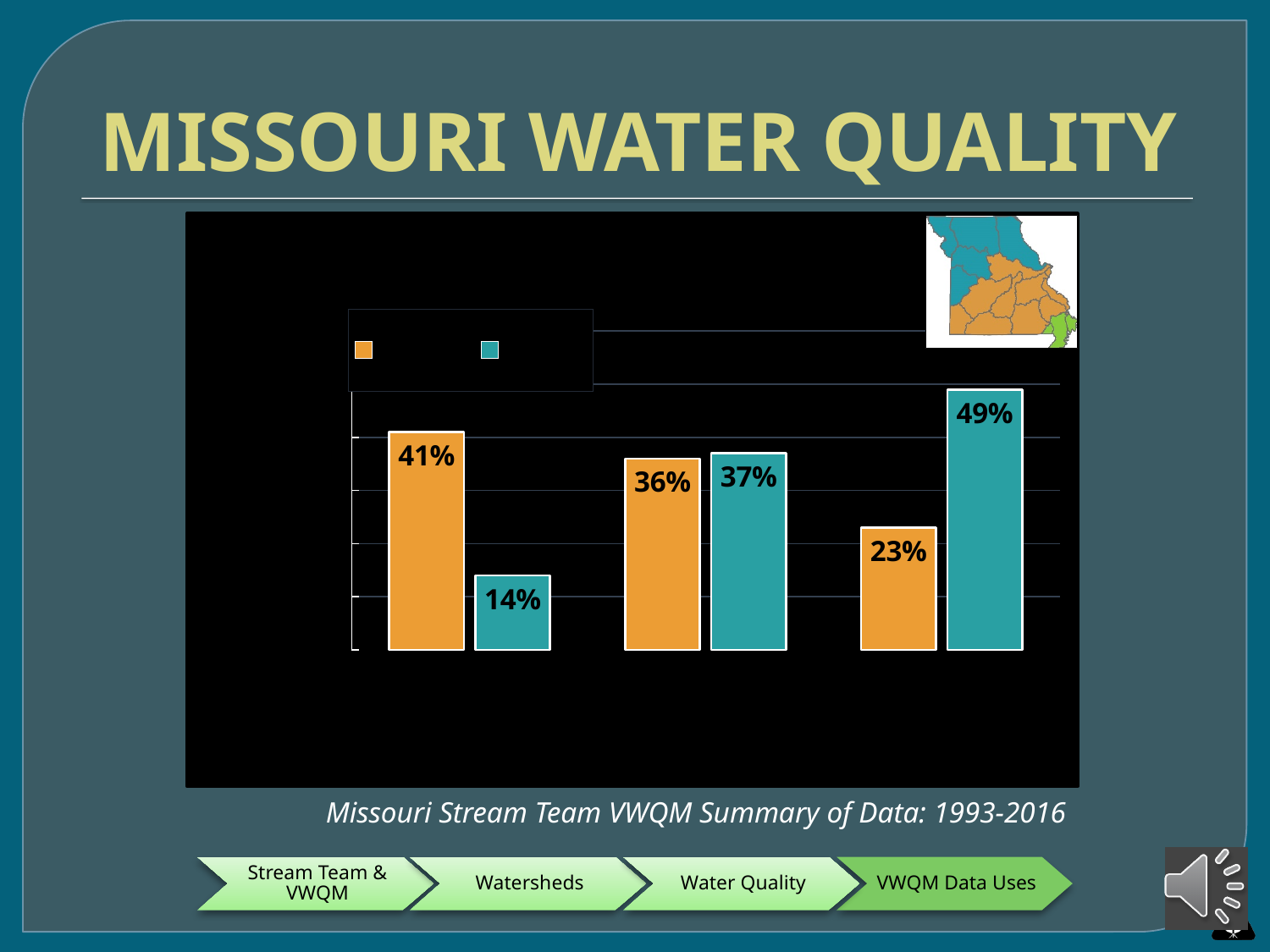
What is the value of the orange bar in the leftmost group? 41% In the leftmost group, which bar is larger, the orange bar or the teal bar? the orange bar Which bar has the highest value in the chart? the teal bar in the rightmost group (49%) How many bars are plotted in the chart in total? 6 Which bar has the lowest value in the chart? the teal bar in the leftmost group (14%) How many groups of bars are plotted in the chart? 3 What is the value of the teal bar in the leftmost group? 14% What is the value of the orange bar in the middle group? 36% How many series does the chart's legend show (by colour swatch)? 2 What is the difference between the teal bar and the orange bar in the rightmost group? 26% What is the value of the teal bar in the rightmost group? 49% What kind of chart is shown on the slide? bar chart